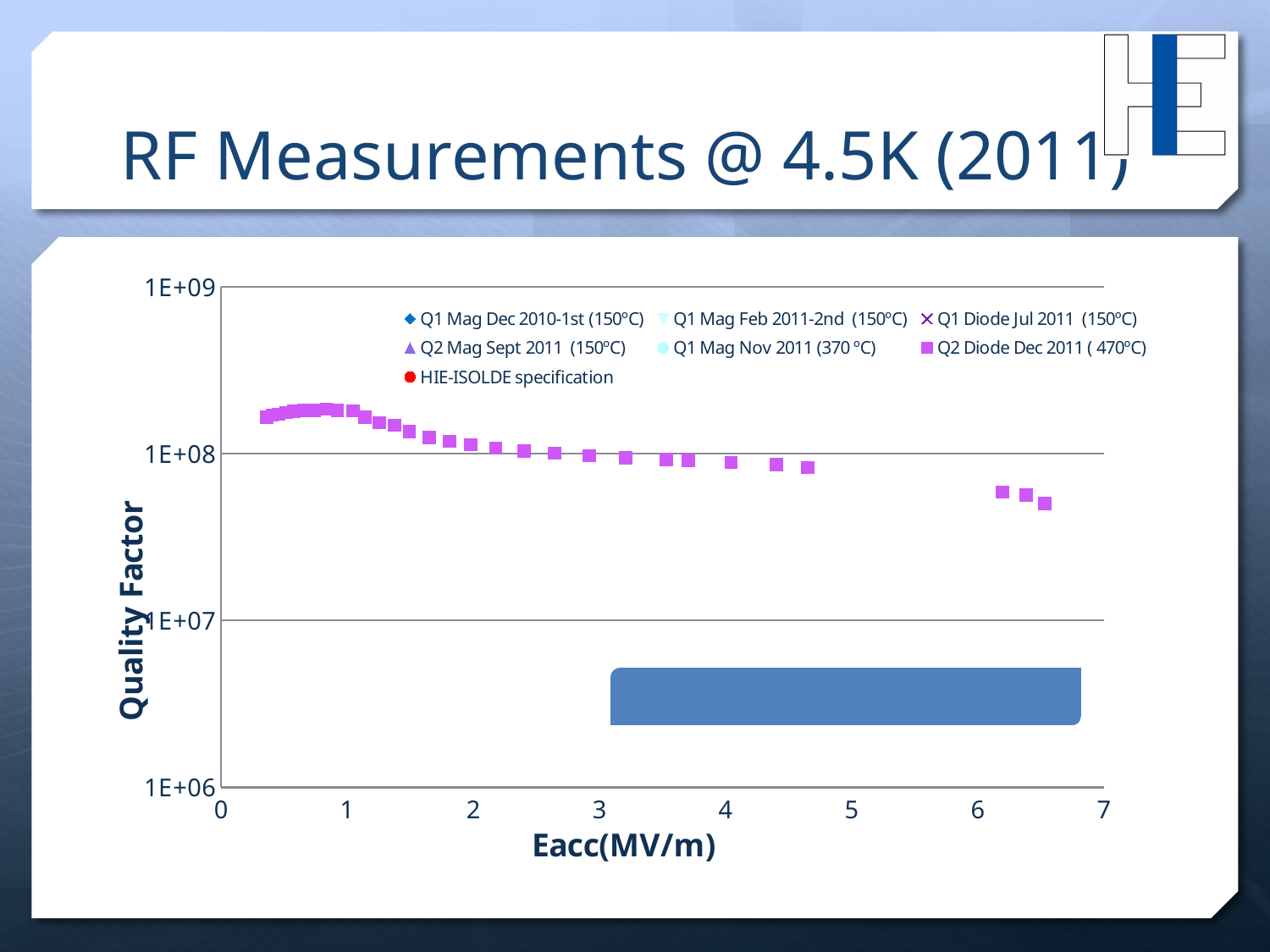
What is the title of the chart's x axis? Eacc(MV/m) Is the Quality Factor of the plotted points near Eacc = 6.5 MV/m greater or less than 1E+07? greater What is the title of the chart's y axis? Quality Factor Is the Quality Factor of the plotted points near Eacc = 1 MV/m greater or less than 1E+08? greater What is the highest value shown on the chart's y axis? 1E+09 Is the Quality Factor of the plotted points near Eacc = 6.5 MV/m greater or less than 1E+08? less What kind of chart is shown on the slide? scatter chart Which plotted point has the lower Quality Factor: the one near Eacc = 2 MV/m or the one near Eacc = 6.5 MV/m? the one near Eacc = 6.5 MV/m How many series does the chart's legend list? 7 Do the plotted Quality Factor values rise or fall as Eacc increases beyond 1 MV/m? fall